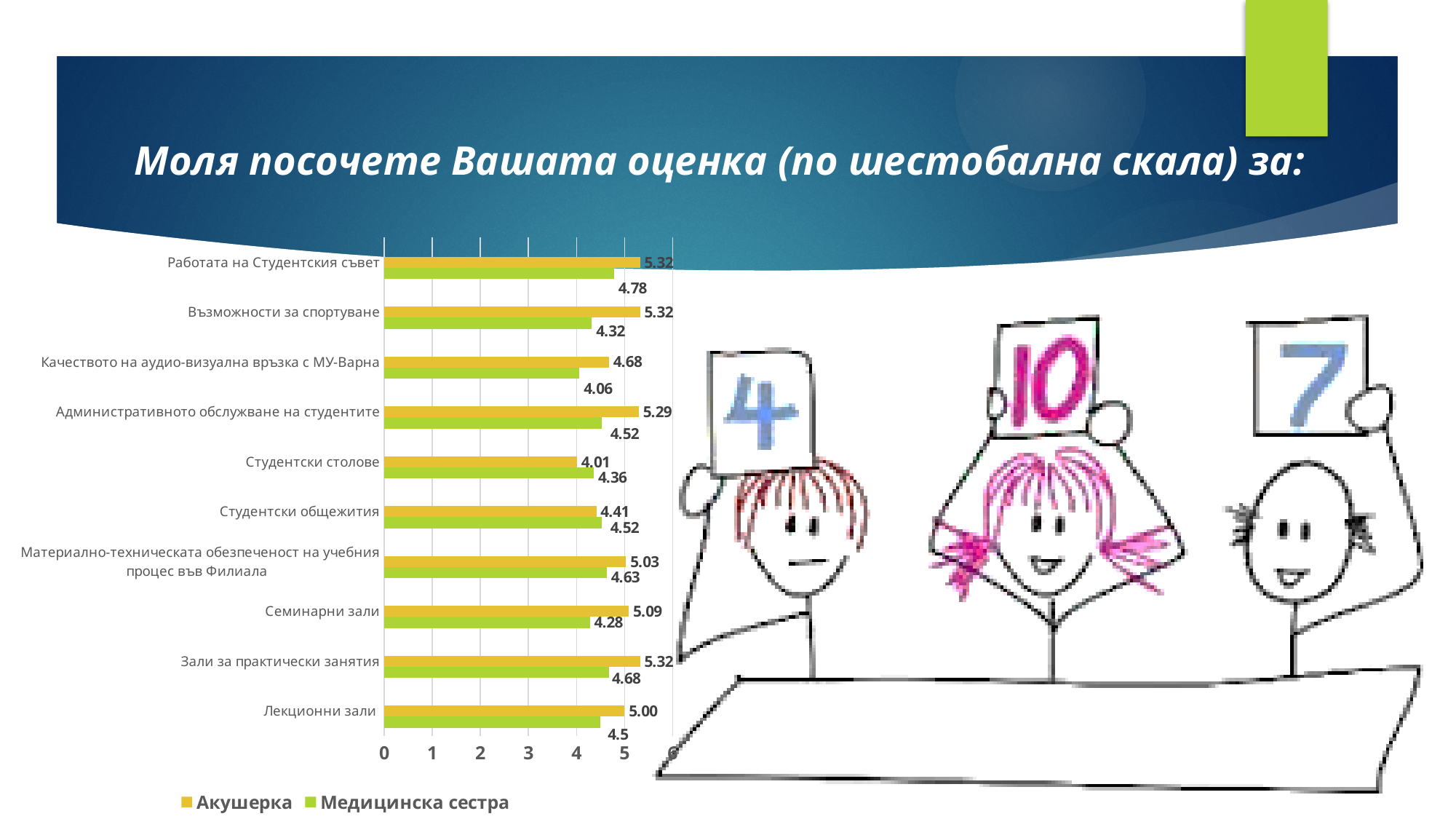
Which category has the lowest value for Медицинска сестра? Качеството на аудио-визуална връзка с МУ-Варна Which category has the lowest value for Акушерка? Студентски столове What is the value for Акушерка for Студентски столове? 4.01 Which category has the highest value for Медицинска сестра? Работата на Студентския съвет Which series is shown in green in the legend? Медицинска сестра What is the difference between the Акушерка and Медицинска сестра values for Семинарни зали? 0.81 What is the value for Медицинска сестра for Възможности за спортуване? 4.32 How many series does the chart legend list? 2 For Студентски общежития, which series has the larger value, Акушерка or Медицинска сестра? Медицинска сестра How many categories are shown on the chart? 10 What is the value for Акушерка for Лекционни зали? 5.00 What type of chart is shown on the slide? bar chart